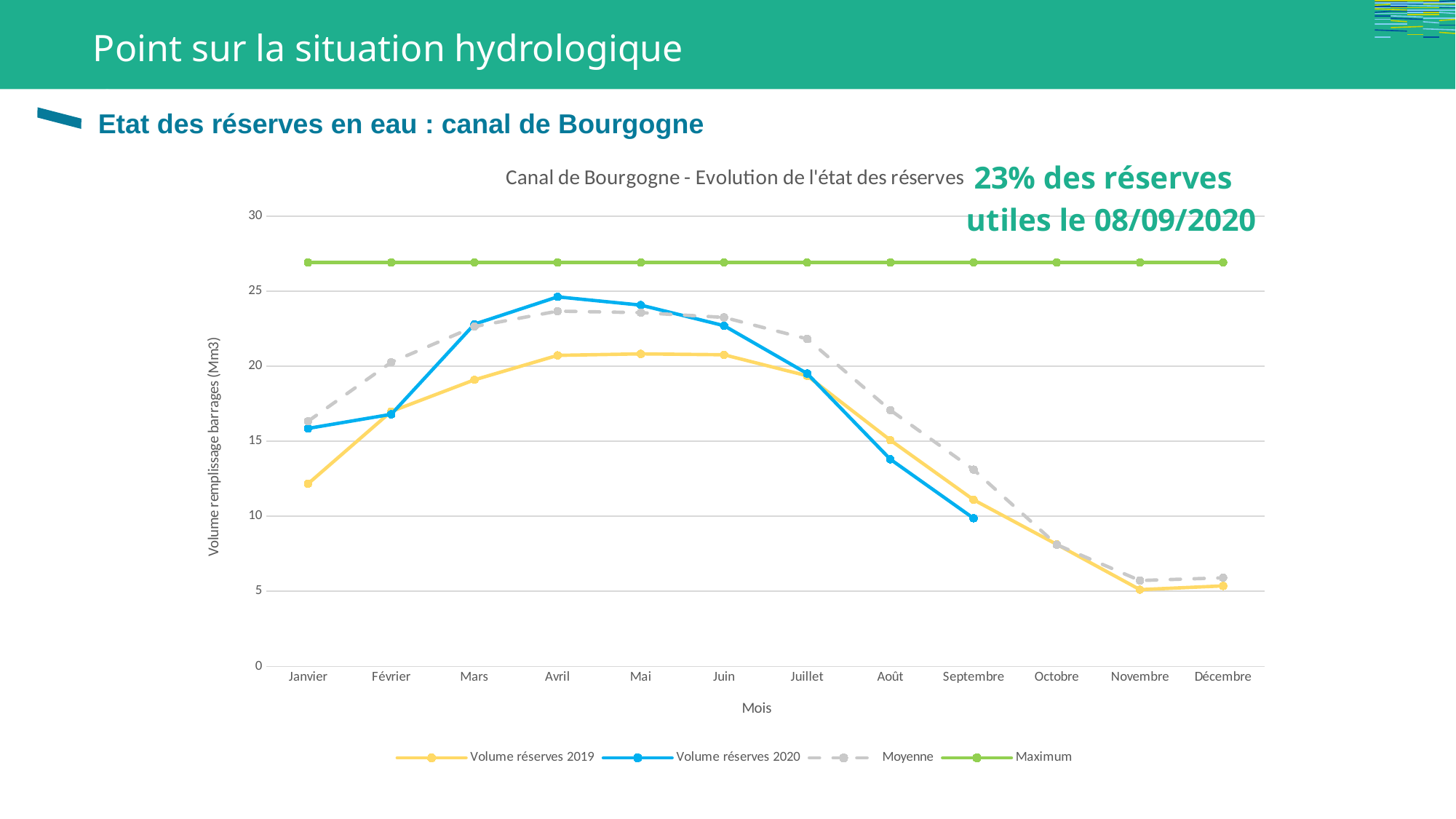
Is the value for Volume réserves 2019 in Janvier greater or less than 10? greater Is the value for Volume réserves 2020 in Avril greater or less than 20? greater What kind of chart is shown on the slide? line chart Is the value for Volume réserves 2019 in Octobre greater or less than 10? less What is the label of the vertical axis? Volume remplissage barrages (Mm3) In which month does the Volume réserves 2020 series reach its highest value? Avril Does the Volume réserves 2020 series rise or fall from Avril to Septembre? fall How many months are shown on the x axis? 12 How many series does the legend list? 4 In Août, which is larger: Volume réserves 2019 or Volume réserves 2020? Volume réserves 2019 What is the title of the chart? Canal de Bourgogne - Evolution de l'état des réserves